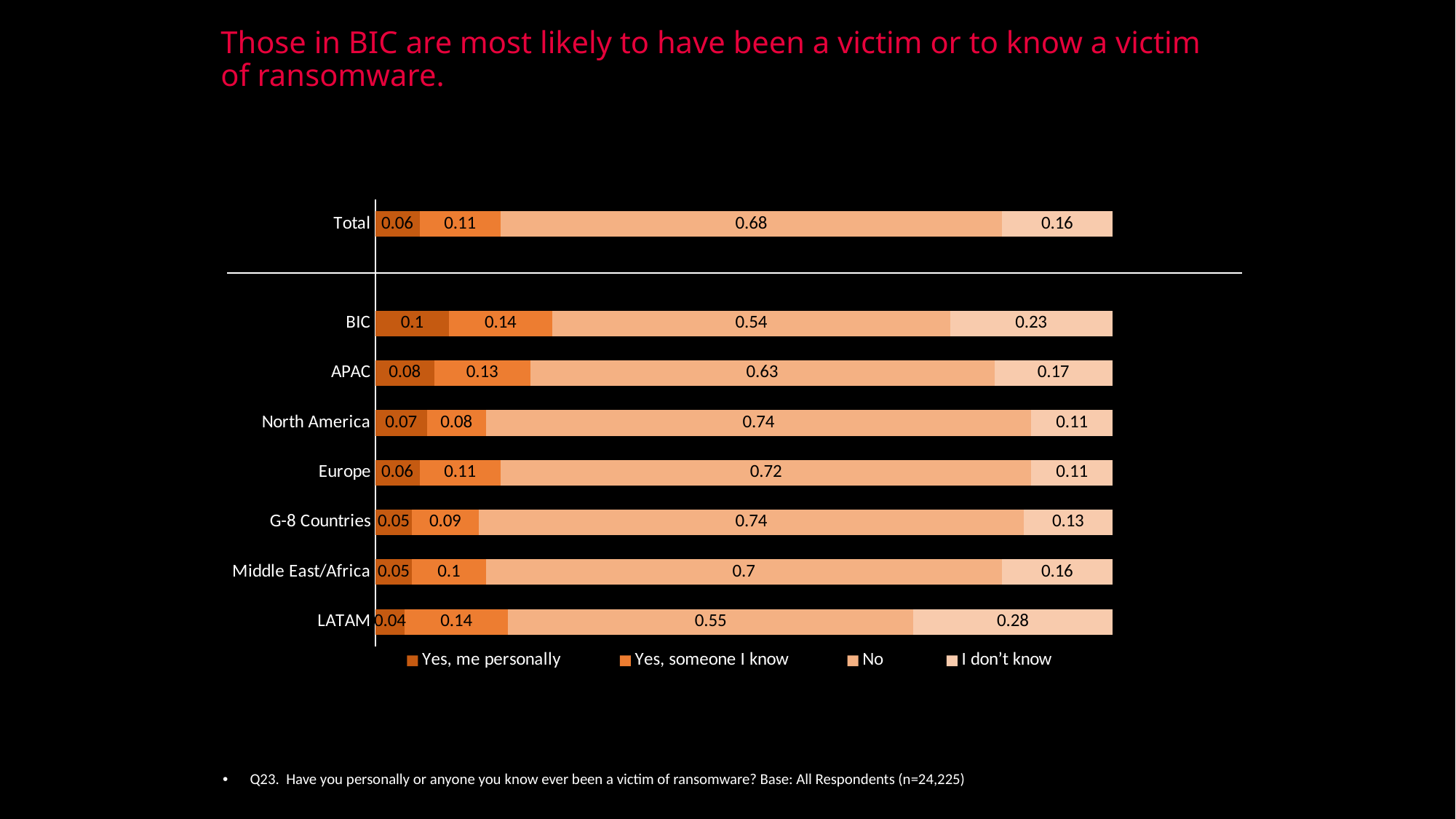
What is the value for "I don't know" for LATAM? 0.28 How many regions are shown in the chart, including Total? 8 What is the value for "Yes, someone I know" for Total? 0.11 What is the difference between the "No" values for North America and LATAM? 0.19 Which is larger, the "I don't know" value for BIC or for APAC? BIC How many series does the legend list? 4 Which region has the highest value for "Yes, me personally"? BIC What is the value for "Yes, me personally" for APAC? 0.08 What is the total of the "Yes, me personally" and "Yes, someone I know" values for BIC? 0.24 What kind of chart is shown on the slide? Stacked bar chart What is the value for "No" for BIC? 0.54 Which region has the lowest value for "No"? BIC